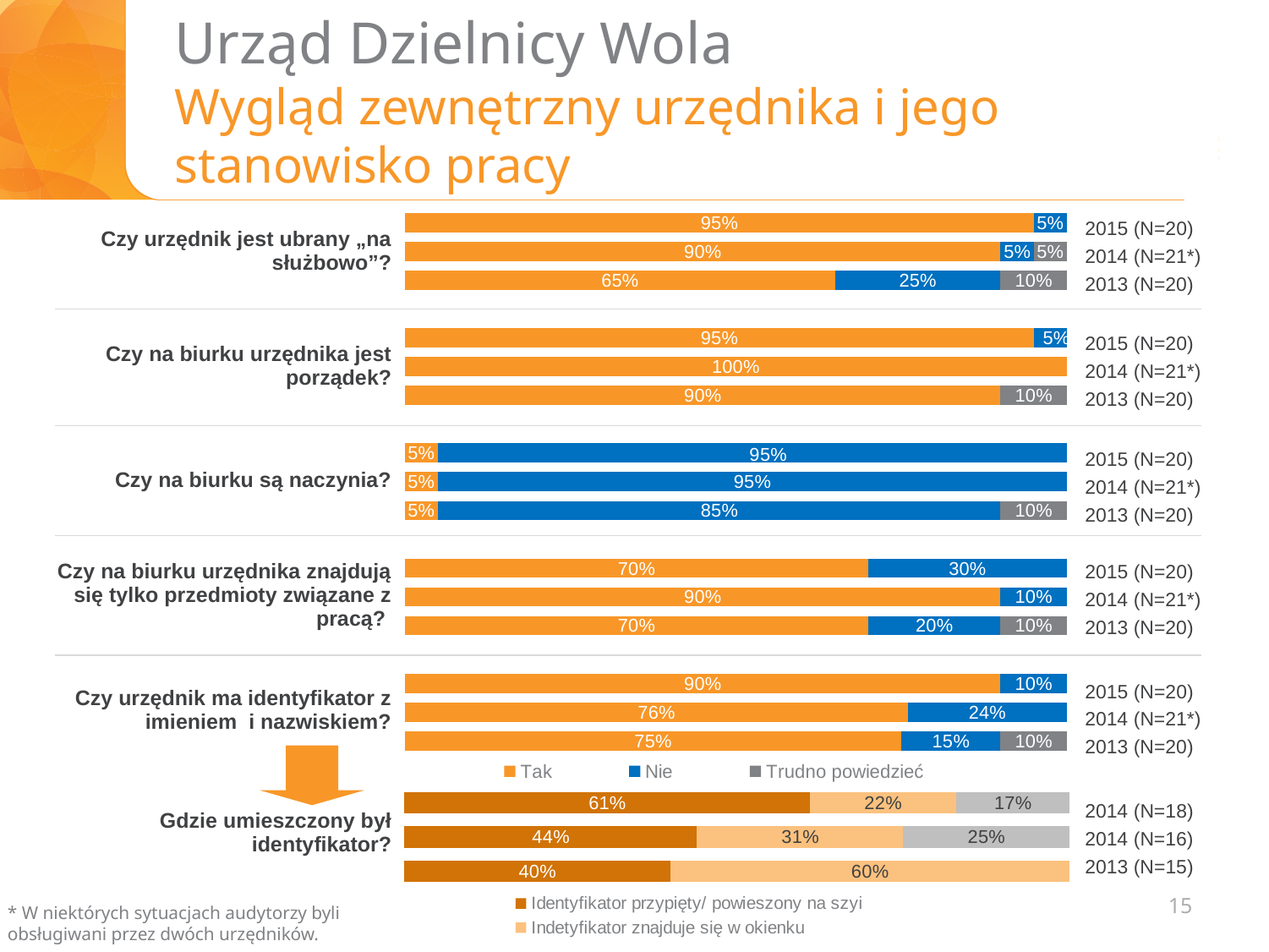
In the upper chart, for "Czy na biurku urzędnika znajdują się tylko przedmioty związane z pracą?", what is the difference between the "Tak" share in 2014 (N=21*) and in 2015 (N=20)? 20 percentage points What type of chart is used on this slide? Stacked bar chart In the upper chart, for "Czy urzędnik ma identyfikator z imieniem i nazwiskiem?", is the "Nie" share larger in 2014 (N=21*) or in 2013 (N=20)? 2014 (N=21*) In the upper chart, for "Czy urzędnik ma identyfikator z imieniem i nazwiskiem?", which year has the highest "Tak" share? 2015 (N=20) In the upper chart, what share answered "Tak" to "Czy urzędnik jest ubrany „na służbowo”?" in 2013 (N=20)? 65% In the lower chart "Gdzie umieszczony był identyfikator?", which bar has the lowest share for "Identyfikator przypięty/ powieszony na szyi"? 2013 (N=15) How many series does the legend of the upper chart list? 3 In the lower chart "Gdzie umieszczony był identyfikator?", what share had the identifier pinned/hung on the neck in 2014 (N=18)? 61% In the upper chart, what share answered "Nie" to "Czy na biurku są naczynia?" in 2013 (N=20)? 85% In the upper chart, what share answered "Tak" to "Czy na biurku urzędnika jest porządek?" in 2014 (N=21*)? 100% In the upper chart, what share answered "Nie" to "Czy urzędnik jest ubrany „na służbowo”?" in 2013 (N=20)? 25% In the lower chart "Gdzie umieszczony był identyfikator?", what share had the identifier in the window in 2013 (N=15)? 60%